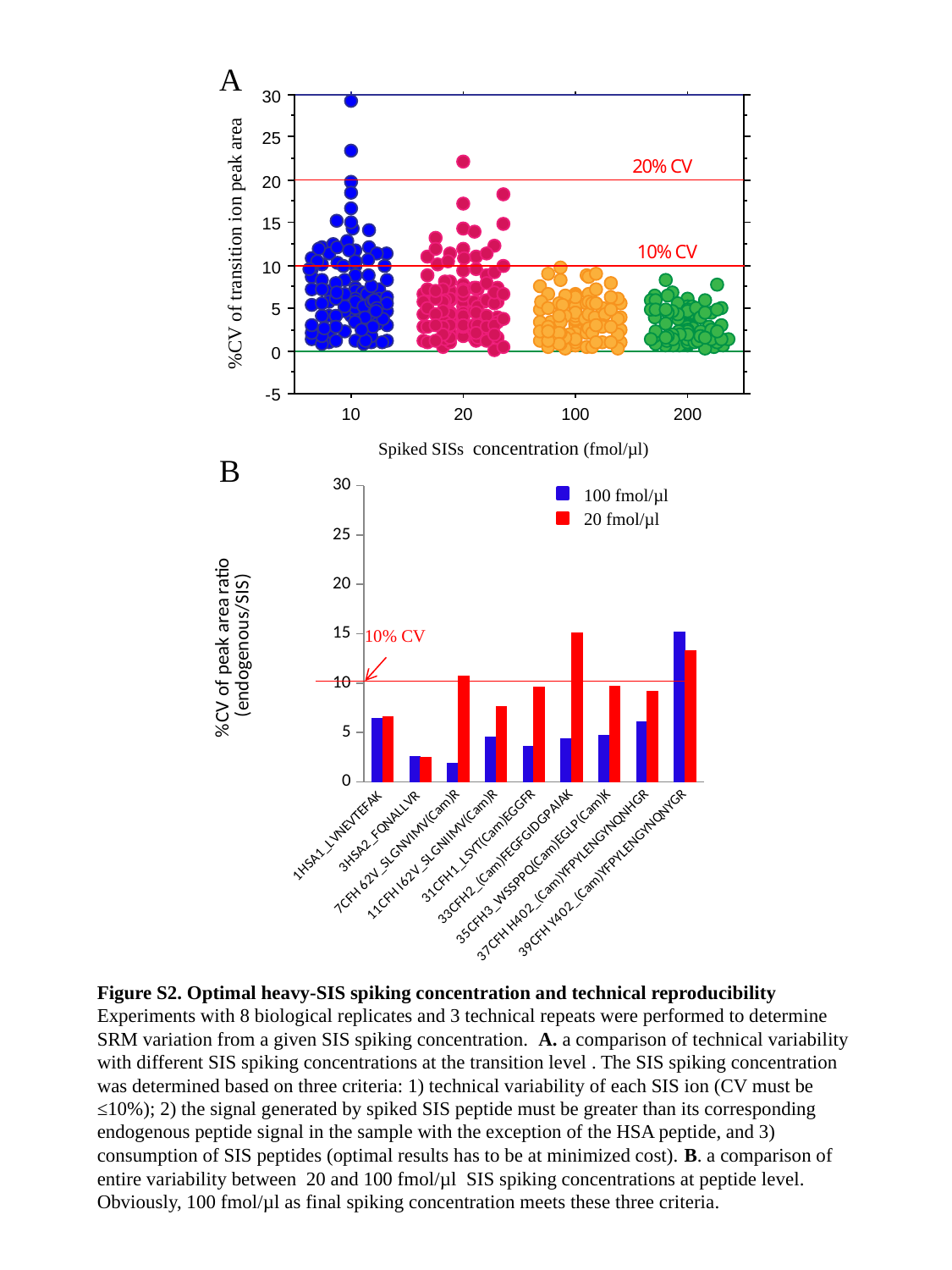
In chart B, how many series does the legend list? 2 In chart B, which peptide has the highest 20 fmol/µl bar? 33CFH2_(Cam)FEGFGIDGPAIAK In chart B, which peptide has the highest 100 fmol/µl bar? 39CFH Y402_(Cam)YFPYLENGYNQNYGR In chart A, how many spiked SIS concentration groups are plotted on the x axis? 4 In chart A, which spiked SIS concentration group contains the highest %CV point? 10 In chart B, what are the two series named in the legend? 100 fmol/µl and 20 fmol/µl What kind of chart is chart B? Bar chart In chart B, is the 20 fmol/µl value for 33CFH2_(Cam)FEGFGIDGPAIAK greater or less than 10? greater In chart B, is the 20 fmol/µl value for 11CFH 162V_SLGNIIMV(Cam)R greater or less than 10? less In chart B, which peptide has the lowest 20 fmol/µl bar? 3HSA2_FQNALLVR In chart B, how many peptides are shown on the x axis? 9 In chart B, for 33CFH2_(Cam)FEGFGIDGPAIAK, which series has the larger value, 100 fmol/µl or 20 fmol/µl? 20 fmol/µl